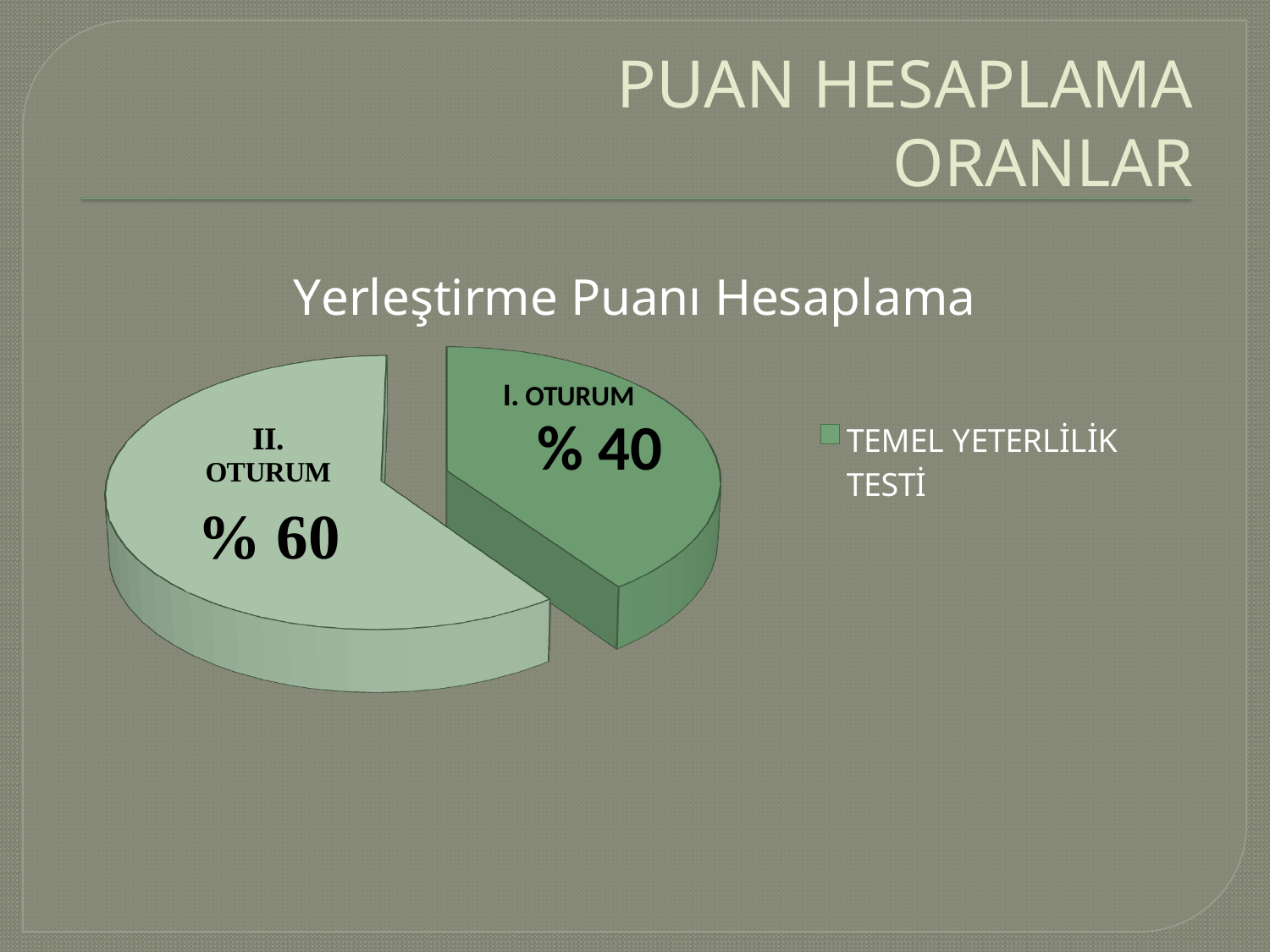
What value is shown for the I. OTURUM slice? % 40 Which slice is the largest? II. OTURUM Which slice is the smallest? I. OTURUM What is the title of the chart? Yerleştirme Puanı Hesaplama Is the value for I. OTURUM greater or less than 50? less Which is larger, the I. OTURUM slice or the II. OTURUM slice? II. OTURUM What value is shown for the II. OTURUM slice? % 60 What share of the pie does the II. OTURUM slice represent? % 60 What entry is listed in the chart legend? TEMEL YETERLİLİK TESTİ What is the difference between the II. OTURUM and I. OTURUM values? % 20 How many slices does the pie chart have? 2 What kind of chart is shown on the slide? pie chart